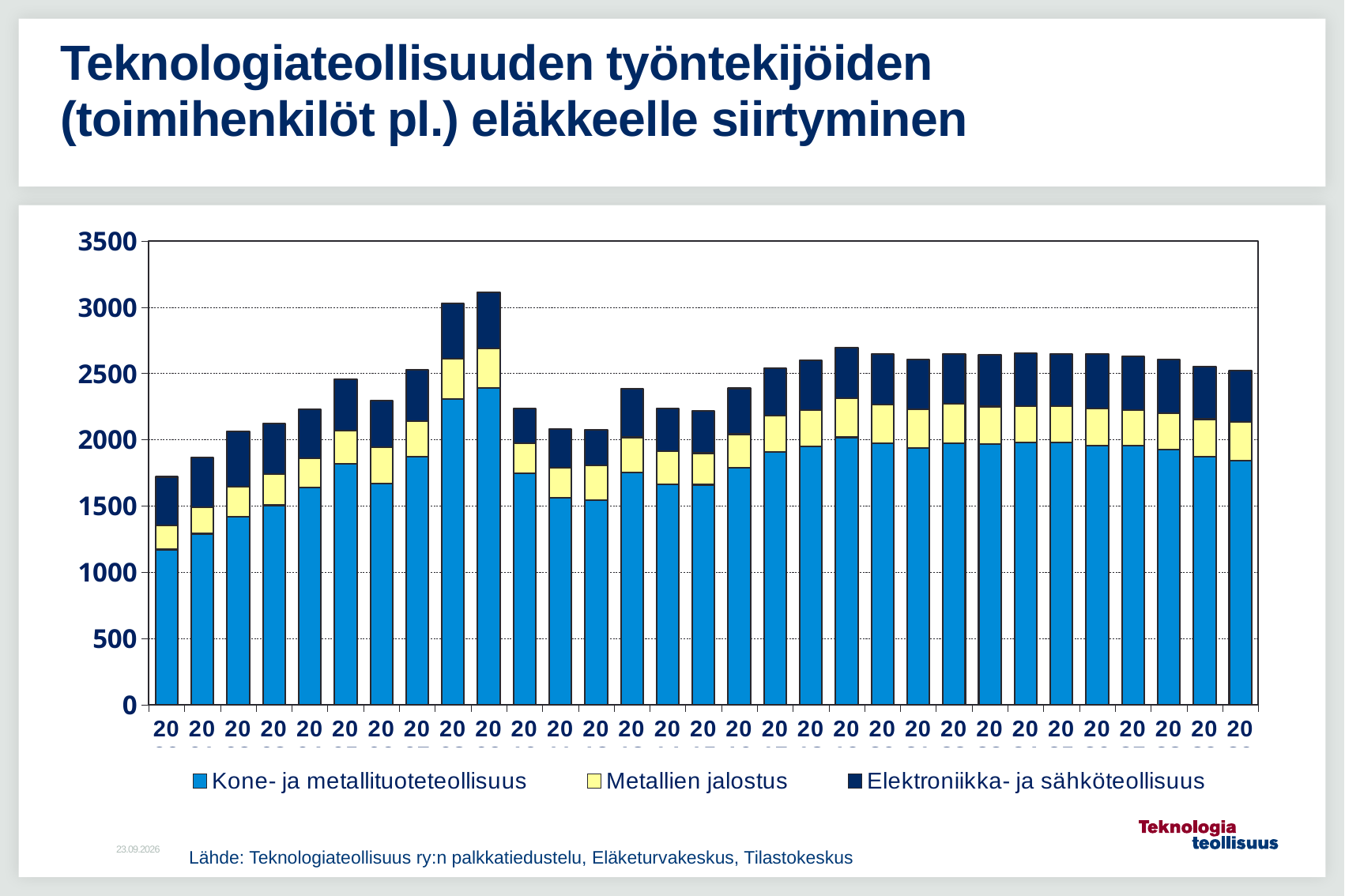
What is the highest value shown on the y axis? 3500 Which bar is the tallest: the ninth bar or the tenth bar from the left? the tenth bar Is the total of the first (leftmost) bar greater or less than 2000? less How many series does the legend list? 3 Do the bar totals rise or fall from the first bar to the sixth bar? rise Which series is shown in yellow in the legend? Metallien jalostus Is the total of the last (rightmost) bar greater or less than 2000? greater Which series is shown in dark navy blue in the legend? Elektroniikka- ja sähköteollisuus What kind of chart is shown on the slide? stacked bar chart How many bars are plotted in the chart? 31 Which bar has the lowest total in the chart? the first (leftmost) bar Is the total of the tallest bar greater or less than 3000? greater